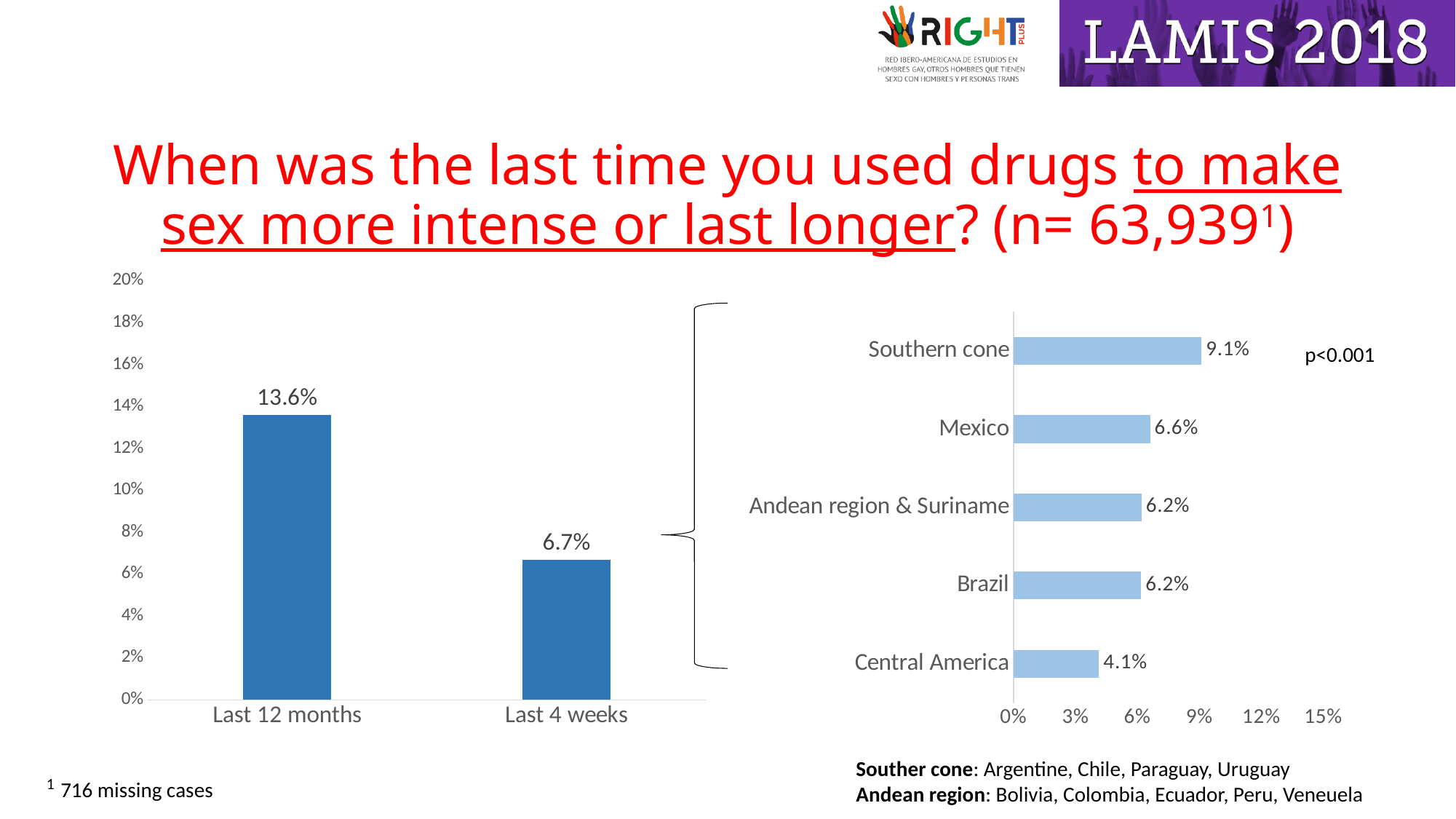
In the left chart, what is the value for Last 12 months? 13.6% In the right chart, which region has the highest value? Southern cone In the right chart, what is the value for Southern cone? 9.1% In the right chart, what is the difference between the Southern cone and Mexico values? 2.5% In the left chart, how many categories are shown? 2 In the right chart, which is larger, the value for Mexico or the value for Central America? Mexico What kind of chart is the left chart? Bar chart In the left chart, what is the value for Last 4 weeks? 6.7% In the right chart, how many regions are shown? 5 In the right chart, which region has the lowest value? Central America In the left chart, what is the difference between the Last 12 months and Last 4 weeks values? 6.9% In the right chart, what is the value for Central America? 4.1%